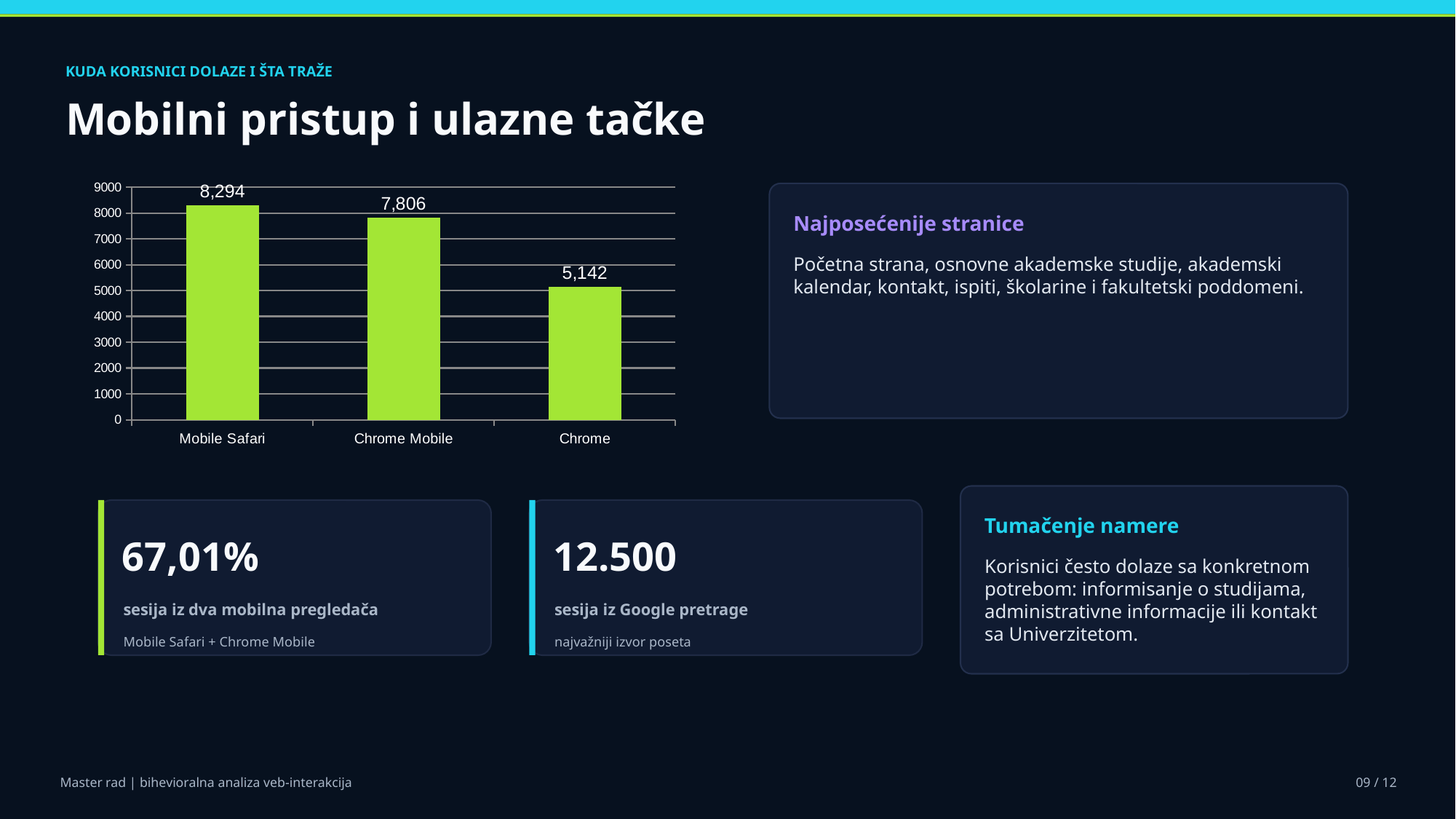
Which category has the lowest value? Chrome Do the values rise or fall from left to right across the categories? fall Which category has the highest value? Mobile Safari Is the value for Chrome greater or less than 6000? less How many categories are shown in the chart? 3 What is the value for Chrome? 5,142 What is the difference between the values for Mobile Safari and Chrome Mobile? 488 Which is larger, the value for Chrome Mobile or the value for Chrome? Chrome Mobile What is the value for Mobile Safari? 8,294 What is the difference between the values for Chrome Mobile and Chrome? 2,664 What kind of chart is shown on the slide? bar chart What is the value for Chrome Mobile? 7,806